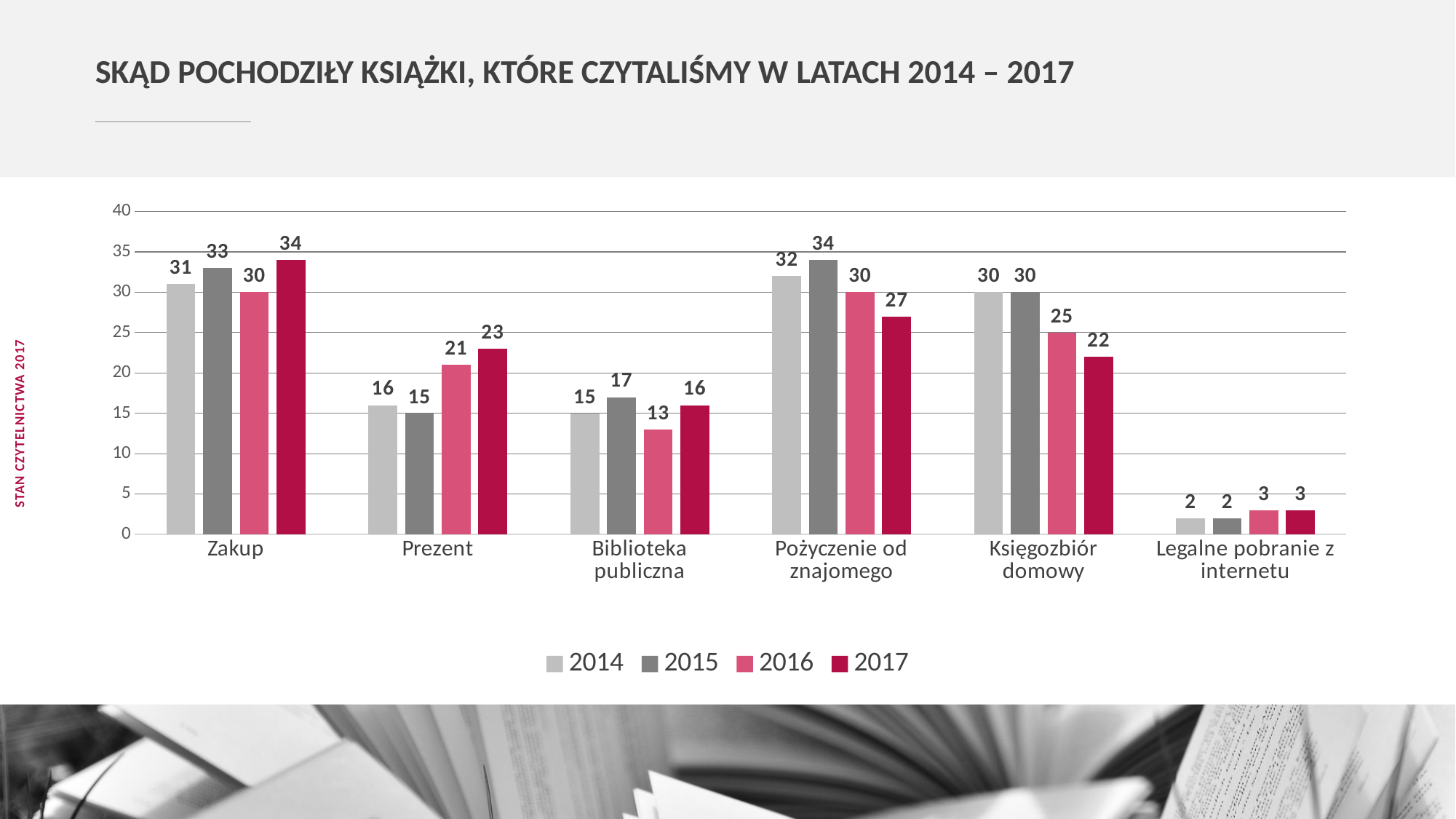
Which category has the lowest value in 2015? Legalne pobranie z internetu Do the values for Księgozbiór domowy rise or fall from 2014 to 2017? Fall How many categories are shown on the x axis? 6 How many series does the legend list? 4 What is the value for Księgozbiór domowy in 2014? 30 What kind of chart is shown on the slide? Bar chart What is the value for Biblioteka publiczna in 2016? 13 Which is larger for Prezent: the 2014 value or the 2017 value? 2017 Which category has the highest value in 2017? Zakup What is the value for Zakup in 2017? 34 What is the difference between the 2015 and 2017 values for Pożyczenie od znajomego? 7 Which series is shown in the darkest red colour in the legend? 2017